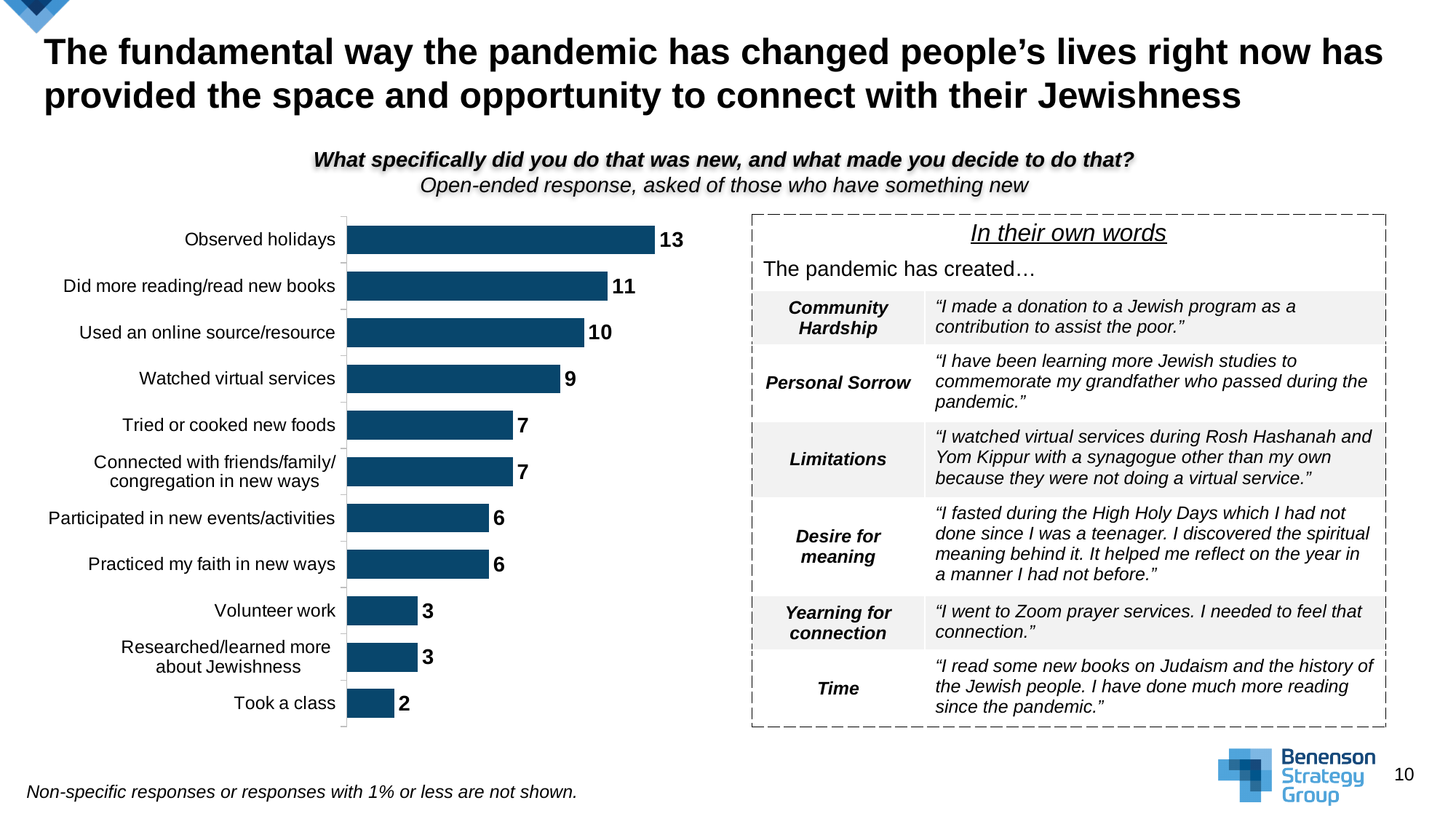
What is the difference between "Observed holidays" and "Did more reading/read new books"? 2 What is the value for "Used an online source/resource"? 10 What is the value for "Observed holidays"? 13 What is the difference between "Watched virtual services" and "Volunteer work"? 6 What kind of chart is shown on the slide? Bar chart Which category has the highest value? Observed holidays What is the value for "Watched virtual services"? 9 What is the value for "Practiced my faith in new ways"? 6 Which is larger, "Used an online source/resource" or "Tried or cooked new foods"? Used an online source/resource How many categories are shown in the bar chart? 11 What is the value for "Took a class"? 2 Which category has the lowest value? Took a class